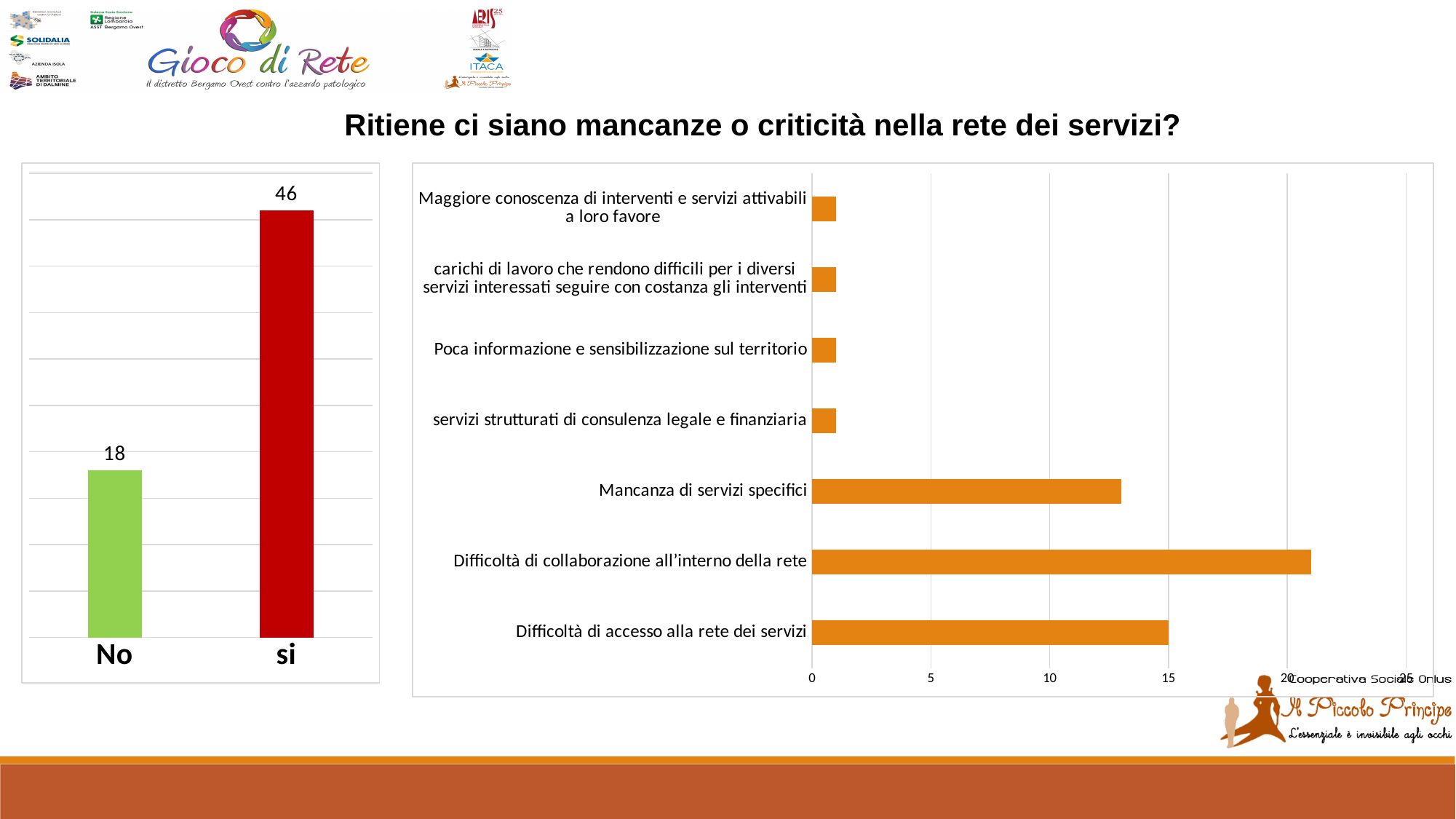
In the left chart, what is the value for "No"? 18 In the left chart, what is the value for "si"? 46 In the left chart, how many categories are shown? 2 What kind of chart is the right chart? Bar chart In the right chart, is the value for "Mancanza di servizi specifici" greater or less than 10? greater In the right chart, is the value for "Difficoltà di collaborazione all'interno della rete" greater or less than 20? greater In the right chart, is the value for "Poca informazione e sensibilizzazione sul territorio" greater or less than 5? less In the right chart, how many categories are shown? 7 In the left chart, what colour is the bar for "No"? Green In the left chart, what is the difference between the values for "si" and "No"? 28 In the left chart, which category has the higher value, "No" or "si"? si In the right chart, which category has the highest value? Difficoltà di collaborazione all'interno della rete